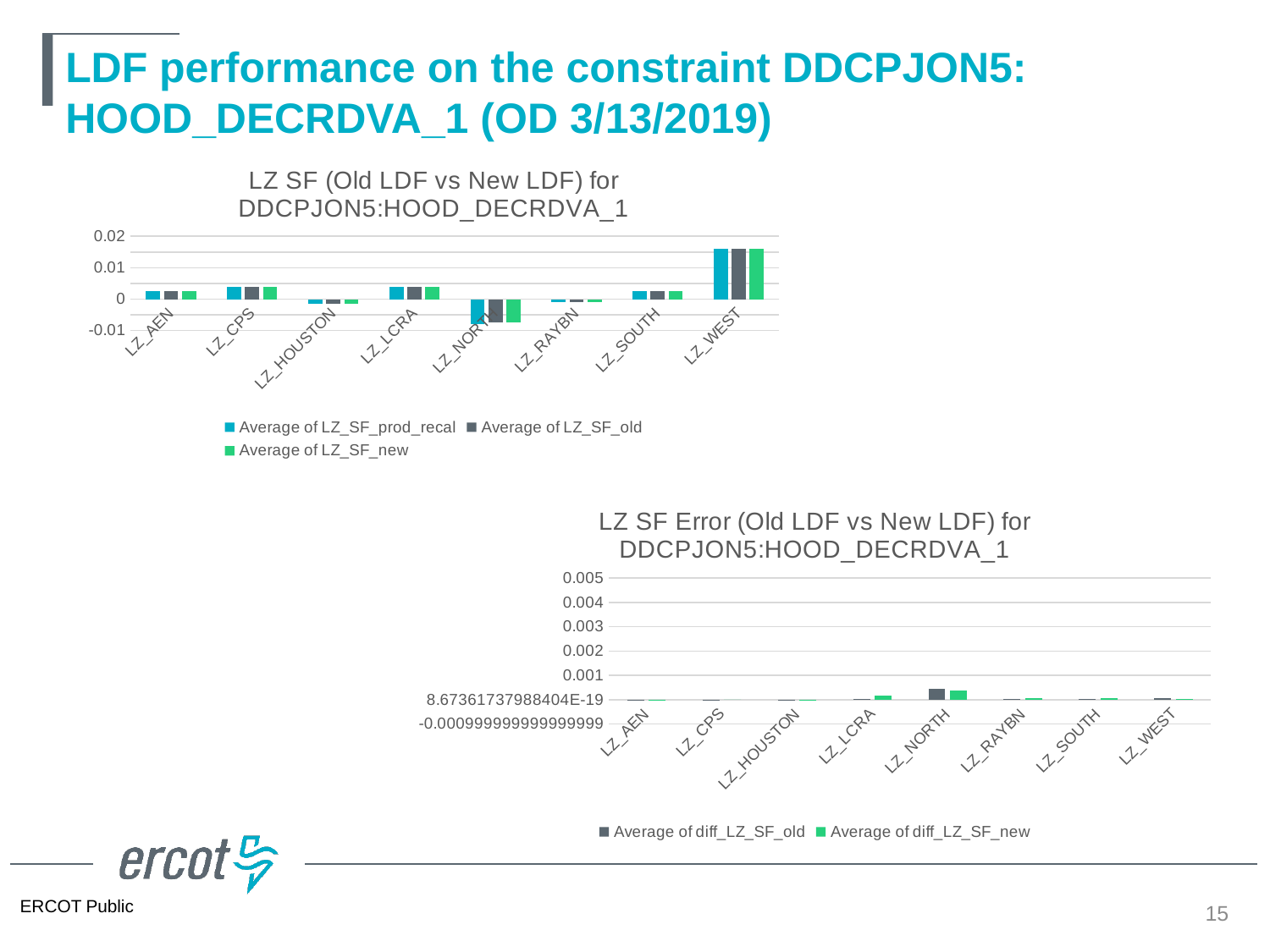
What type of chart is the top chart titled 'LZ SF (Old LDF vs New LDF) for DDCPJON5:HOOD_DECRDVA_1'? Bar chart How many categories are shown on the x axis of the top chart 'LZ SF (Old LDF vs New LDF)'? 8 How many series does the legend of the bottom chart 'LZ SF Error (Old LDF vs New LDF)' list? 2 In the bottom chart 'LZ SF Error (Old LDF vs New LDF)', which category has the highest error values? LZ_NORTH In the top chart 'LZ SF (Old LDF vs New LDF)', which is larger: the Average of LZ_SF_old for LZ_WEST or for LZ_CPS? LZ_WEST In the top chart 'LZ SF (Old LDF vs New LDF)', is the value of Average of LZ_SF_new for LZ_WEST greater or less than 0.01? greater In the bottom chart 'LZ SF Error (Old LDF vs New LDF)', is the value of Average of diff_LZ_SF_old for LZ_NORTH greater or less than 0.001? less In the top chart 'LZ SF (Old LDF vs New LDF)', which category has the highest values? LZ_WEST In the top chart 'LZ SF (Old LDF vs New LDF)', is the value of Average of LZ_SF_old for LZ_NORTH greater or less than 0? less In the top chart 'LZ SF (Old LDF vs New LDF)', which category has the lowest (most negative) values? LZ_NORTH What is the name of the third series in the legend of the top chart 'LZ SF (Old LDF vs New LDF)'? Average of LZ_SF_new How many series does the legend of the top chart 'LZ SF (Old LDF vs New LDF)' list? 3